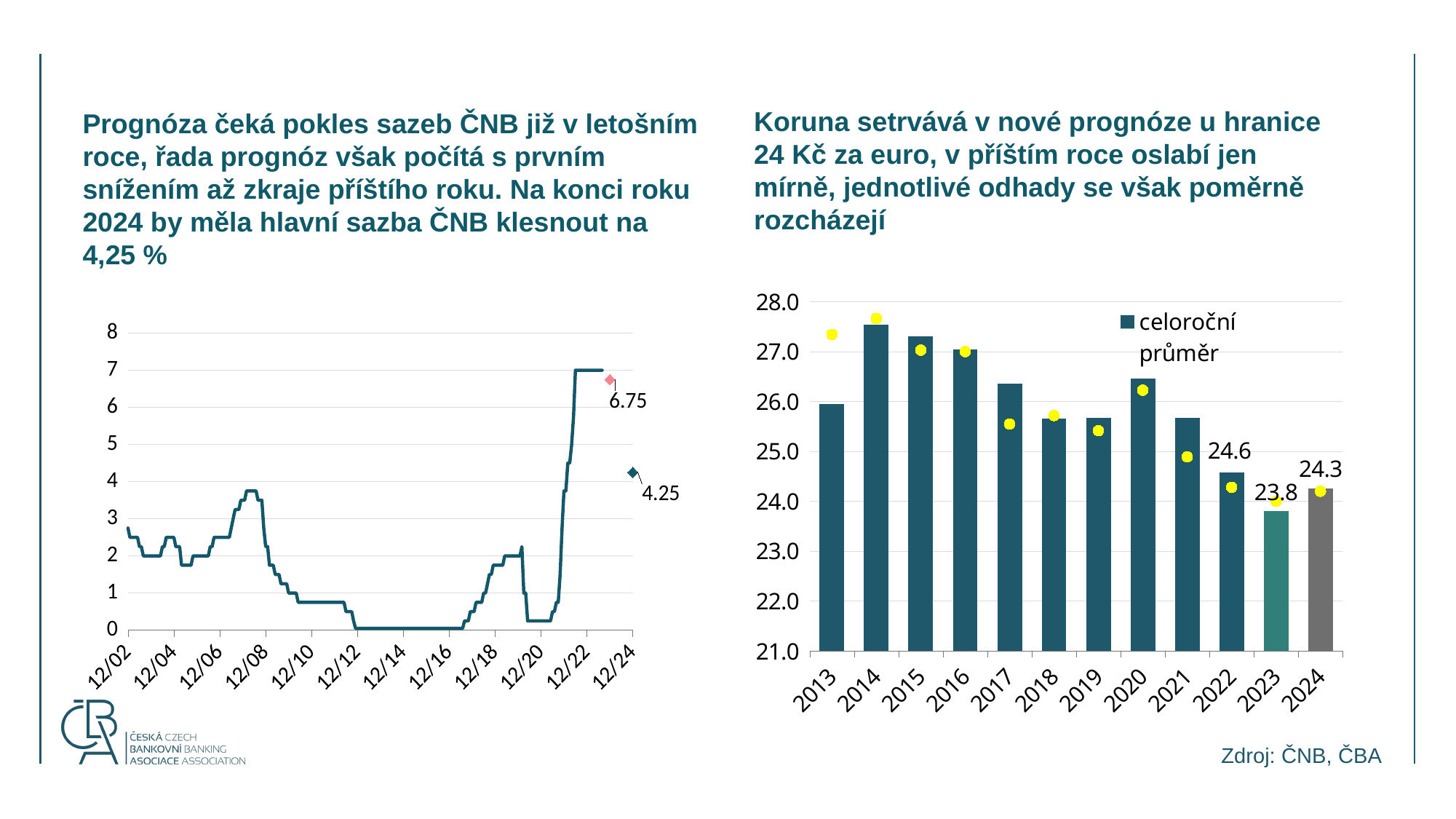
In the right-hand bar chart, which year has the tallest bar? 2014 In the right-hand bar chart, how many years are shown on the x axis? 12 In the right-hand bar chart, what is the value labelled for 2023? 23.8 In the right-hand bar chart, what is the difference between the 2022 value and the 2023 value? 0.8 In the left-hand line chart, what are the two values printed as data labels at the right end of the line? 6.75 and 4.25 In the right-hand bar chart, what is the value labelled for 2024? 24.3 In the right-hand bar chart, what is the legend entry? celoroční průměr In the right-hand bar chart, which year has the shortest bar? 2023 In the right-hand bar chart, what is the value labelled for 2022? 24.6 What kind of chart is the right-hand chart (koruna per euro)? bar chart What kind of chart is the left-hand chart (ČNB rate)? line chart In the right-hand bar chart, is the value for 2017 greater or less than 26.0? greater